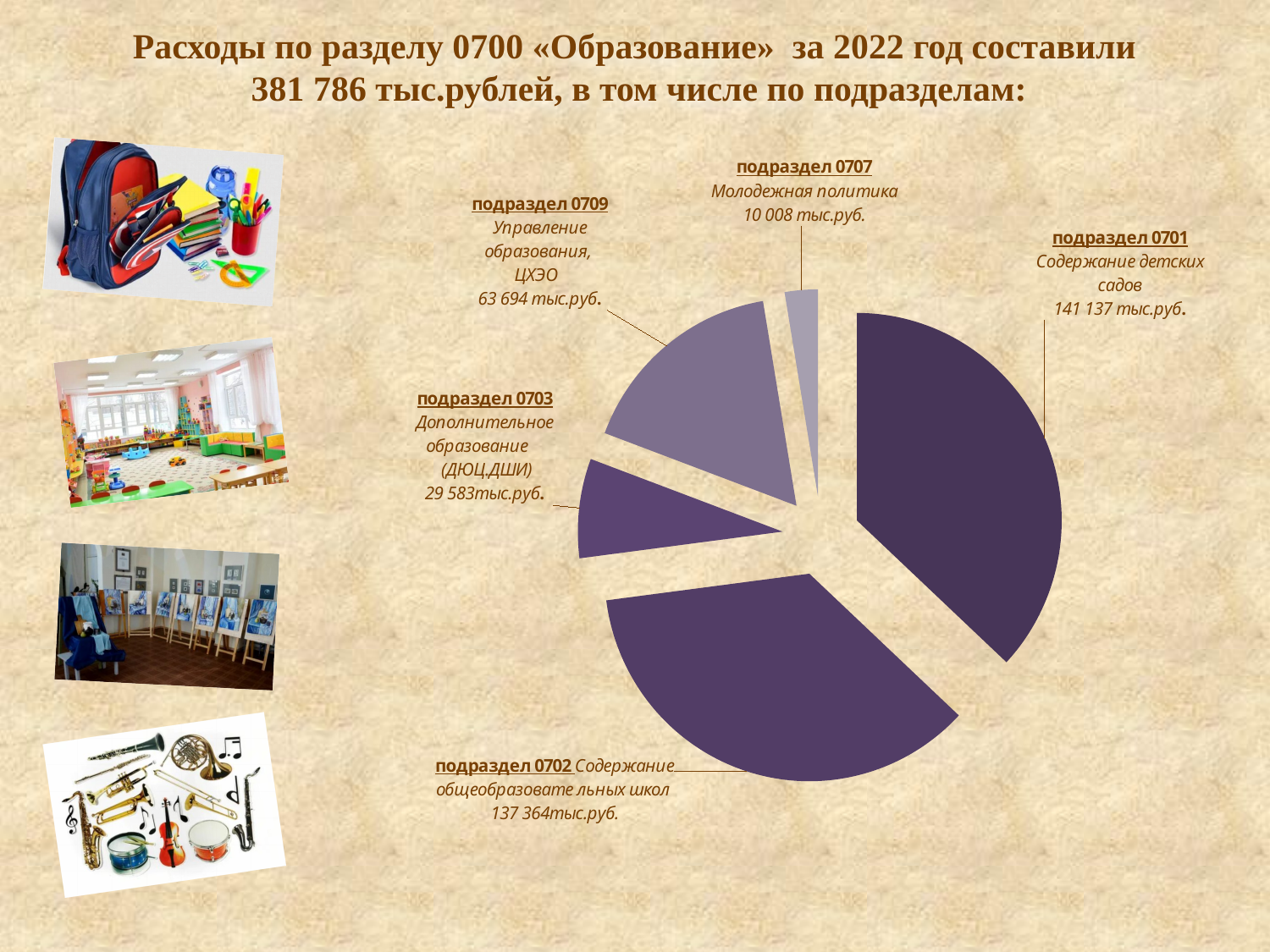
What is the total expenditure for раздел 0700 «Образование» in 2022 according to the slide? 381 786 тыс.рублей What is the value for подраздел 0702 (Содержание общеобразовательных школ)? 137 364 тыс.руб. Which is larger: the value for подраздел 0703 or the value for подраздел 0707? подраздел 0703 What is the value for подраздел 0701 (Содержание детских садов)? 141 137 тыс.руб. What is the value for подраздел 0707 (Молодежная политика)? 10 008 тыс.руб. How many slices does the pie chart have? 5 What kind of chart is shown on the slide? Pie chart What is the difference between the values for подраздел 0709 and подраздел 0703? 34 111 тыс.руб. Which подраздел has the largest expenditure in the pie chart? подраздел 0701 (Содержание детских садов) What is the difference between the values for подраздел 0701 and подраздел 0702? 3 773 тыс.руб. What is the value for подраздел 0709 (Управление образования, ЦХЭО)? 63 694 тыс.руб. Which подраздел has the smallest expenditure in the pie chart? подраздел 0707 (Молодежная политика)